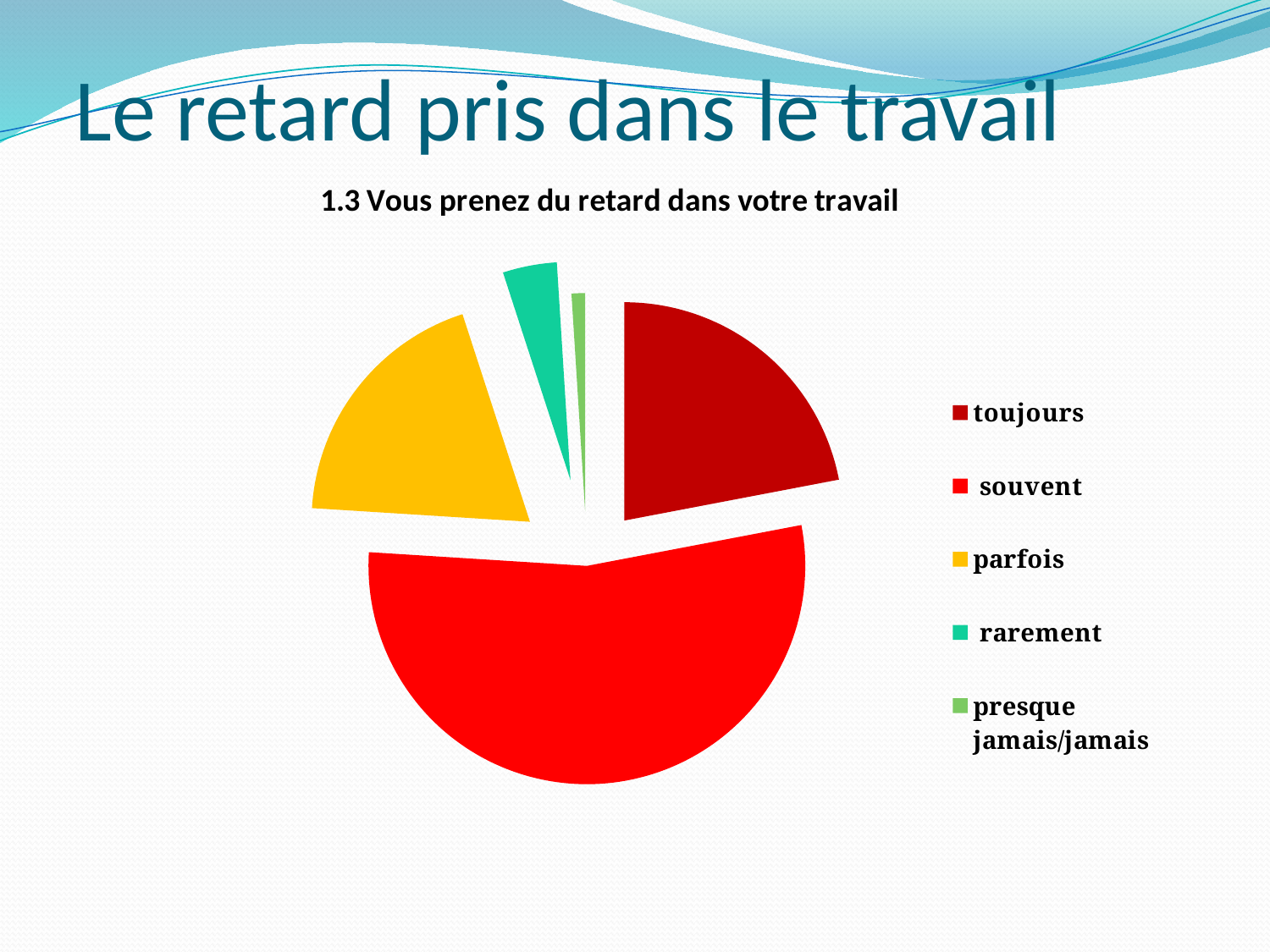
Which category has the largest slice of the pie? souvent Which slice is larger, rarement or presque jamais/jamais? rarement Which slice is larger, parfois or rarement? parfois What kind of chart is shown on the slide? pie chart What colour is the slice for parfois? yellow Which slice is larger, souvent or toujours? souvent What is the title of the chart? 1.3 Vous prenez du retard dans votre travail Which category has the smallest slice of the pie? presque jamais/jamais How many entries does the legend list? 5 How many categories does the pie chart have? 5